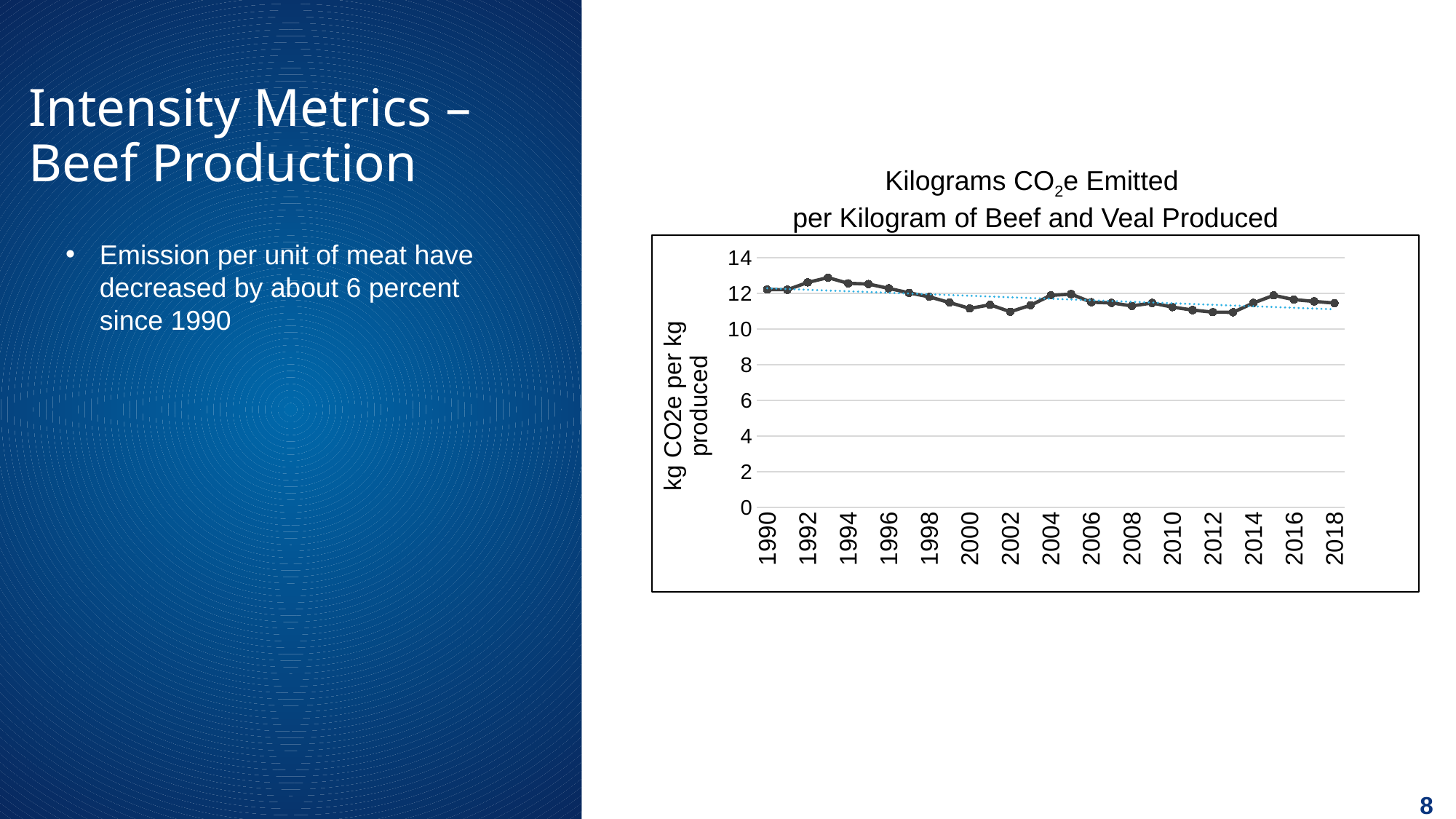
Is the value for 1993 greater or less than 12? greater What is the title of the chart? Kilograms CO2e Emitted per Kilogram of Beef and Veal Produced How many year labels are shown on the x axis? 15 Overall, do the values rise or fall from 1990 to 2018? fall Is the value for 2002 greater or less than 12? less Is the value for 2018 greater or less than 10? greater Which is larger, the value for 2012 or the value for 1990? 1990 Which year has the highest value on the chart? 1993 What kind of chart is shown on the slide? line chart What is the label on the vertical axis of the chart? kg CO2e per kg produced Which is larger, the value for 1993 or the value for 2002? 1993